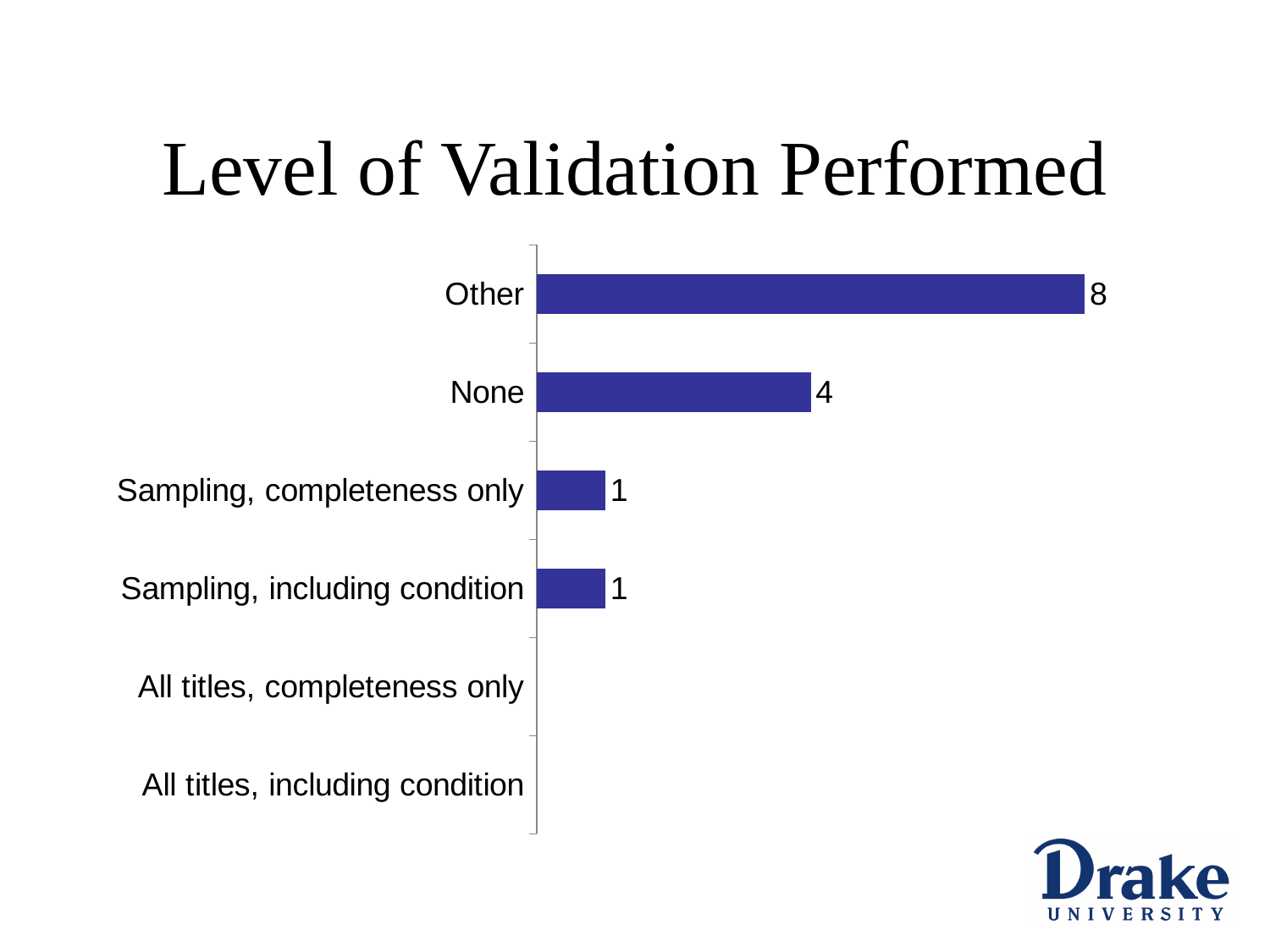
What is the title of the slide? Level of Validation Performed What is the difference between the values for None and Sampling, including condition? 3 What is the difference between the values for Other and None? 4 What kind of chart is shown on the slide? Bar chart What is the value for Other? 8 Which is larger, the value for None or the value for Sampling, completeness only? None What is the value for None? 4 How many categories are shown on the chart? 6 What colour are the bars in the chart? Blue Which category has the highest value? Other What is the value for Sampling, completeness only? 1 What is the value for Sampling, including condition? 1